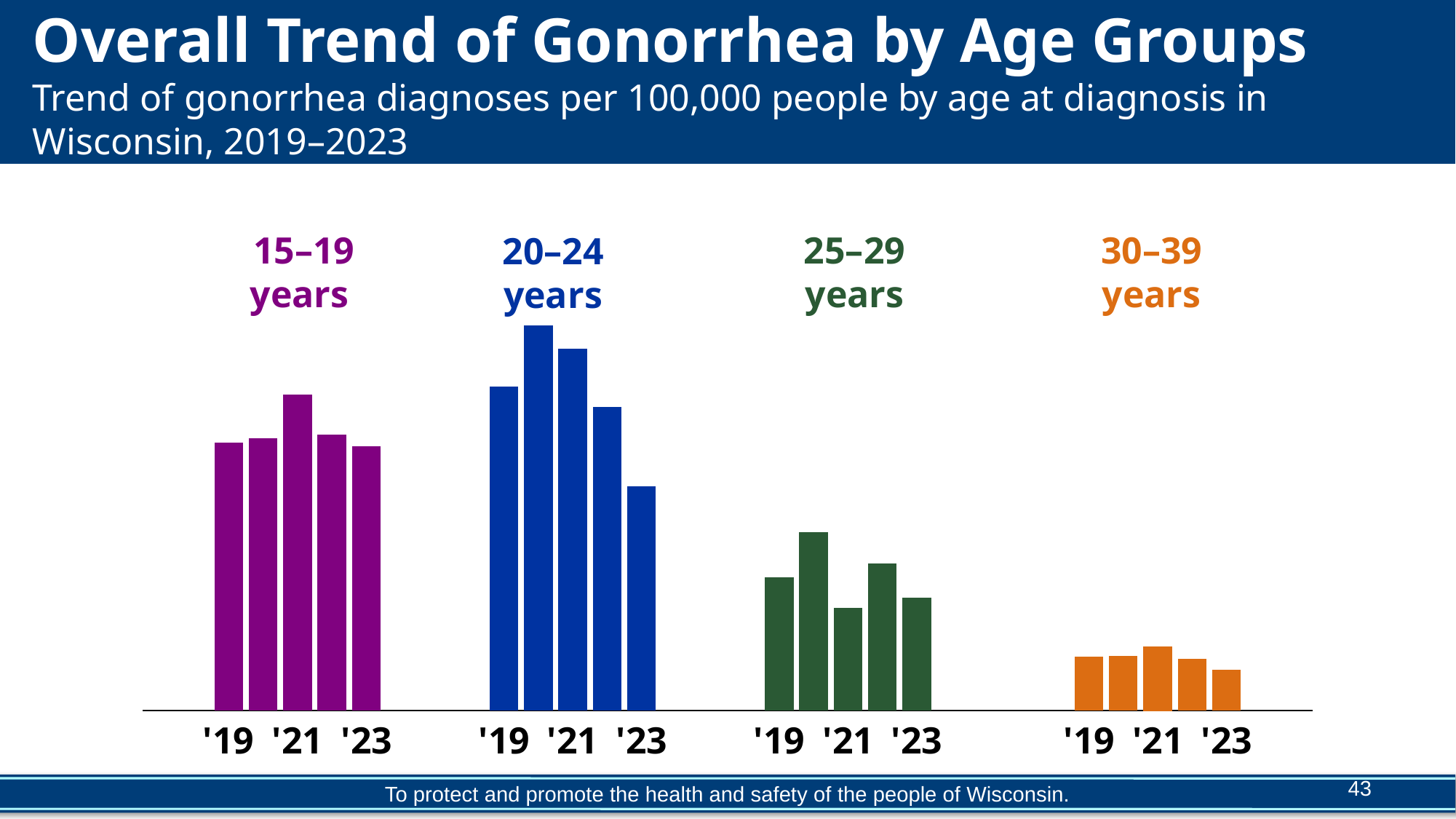
What colour are the bars for the 30–39 years group? orange For the 25–29 years group, which year has the lowest bar? 2021 For the 15–19 years group, which year has the highest bar? 2021 Which is larger: the 2019 value for 20–24 years or the 2019 value for 25–29 years? 20–24 years Which age group has the highest gonorrhea diagnosis rates in the chart? 20–24 years How many bars are plotted for each age group? 5 For the 20–24 years group, do the values rise or fall from 2020 to 2023? fall What kind of chart is shown on the slide? bar chart How many bars are plotted in total across all age groups? 20 Which age group has the lowest gonorrhea diagnosis rates in the chart? 30–39 years How many age groups are shown in the chart? 4 For the 20–24 years group, which year has the highest bar? 2020